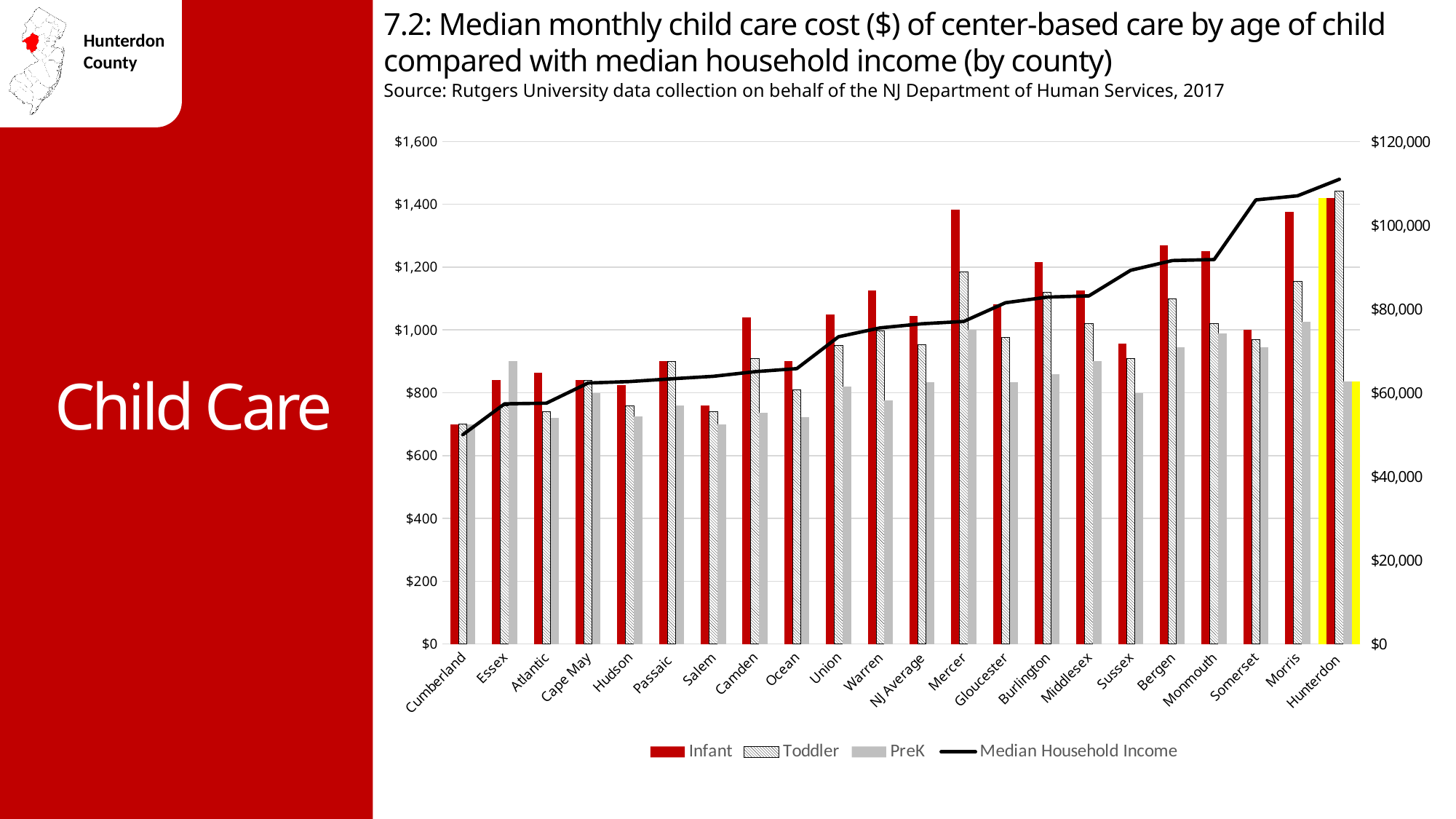
Does the Median Household Income line generally rise or fall from left to right across the counties? rise Is the Infant cost for Mercer greater or less than $1,200? greater How many series does the legend list? 4 What kind of chart is shown on the slide? Bar chart with a line For Warren, which is larger, the Infant cost or the PreK cost? Infant Which county has the highest Toddler cost? Hunterdon Which is larger, the Infant cost for Mercer or the Infant cost for Gloucester? Mercer Which county's bars are highlighted in yellow? Hunterdon Is the Infant cost for Cumberland greater or less than $800? less Is the PreK cost for Hunterdon greater or less than $1,000? less How many counties (including NJ Average) are shown along the x axis? 22 Which county has the lowest Infant cost? Cumberland